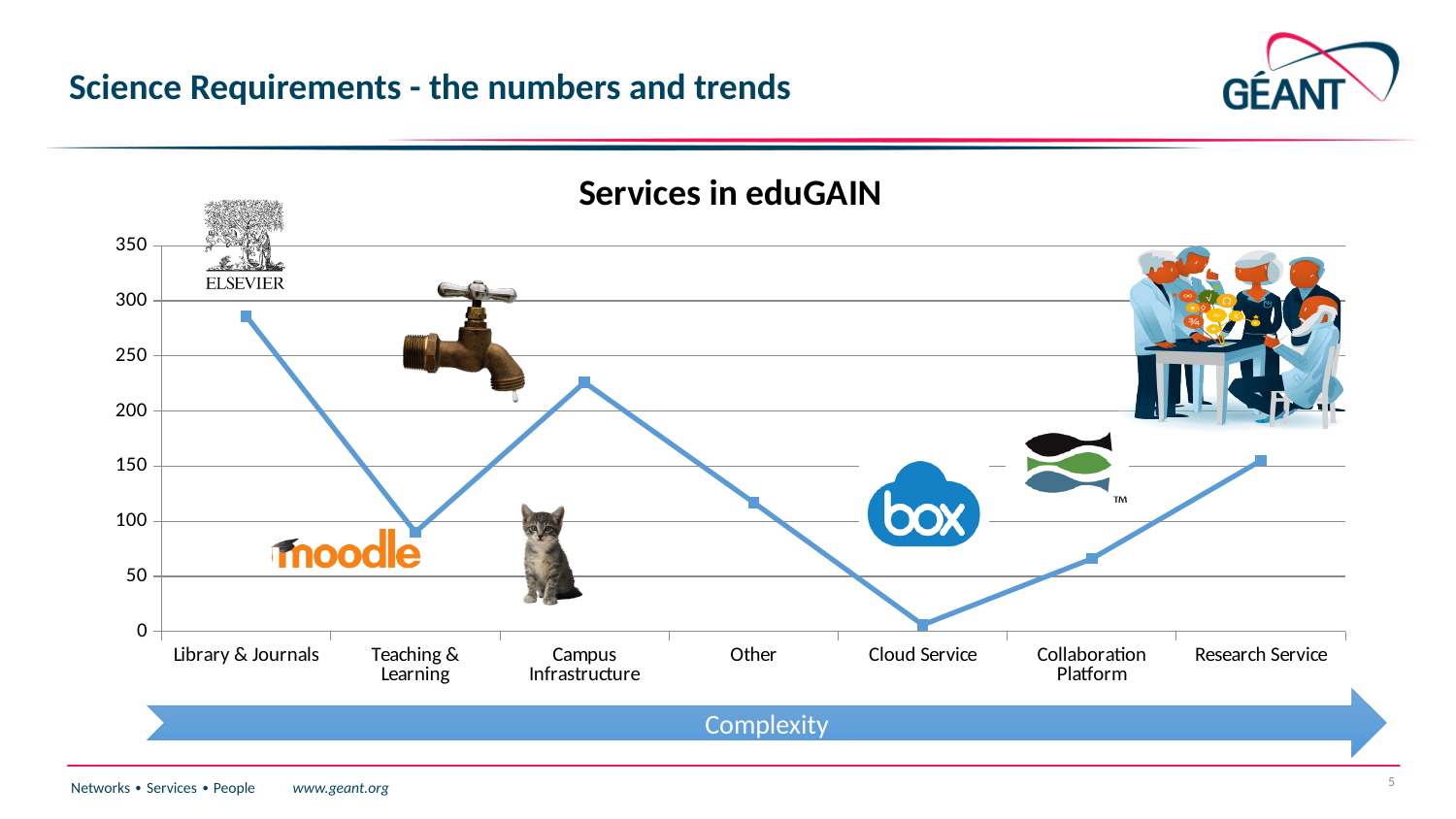
Which category has the highest value? Library & Journals How many categories are plotted on the x axis? 7 Is the value for Cloud Service greater or less than 50? less What type of chart is shown on the slide? line chart Does the line rise or fall from Library & Journals to Teaching & Learning? fall What is the title of the chart? Services in eduGAIN Which is larger, the value for Campus Infrastructure or the value for Other? Campus Infrastructure Is the value for Research Service greater or less than 100? greater Which category has the lowest value? Cloud Service Is the value for Campus Infrastructure greater or less than 200? greater